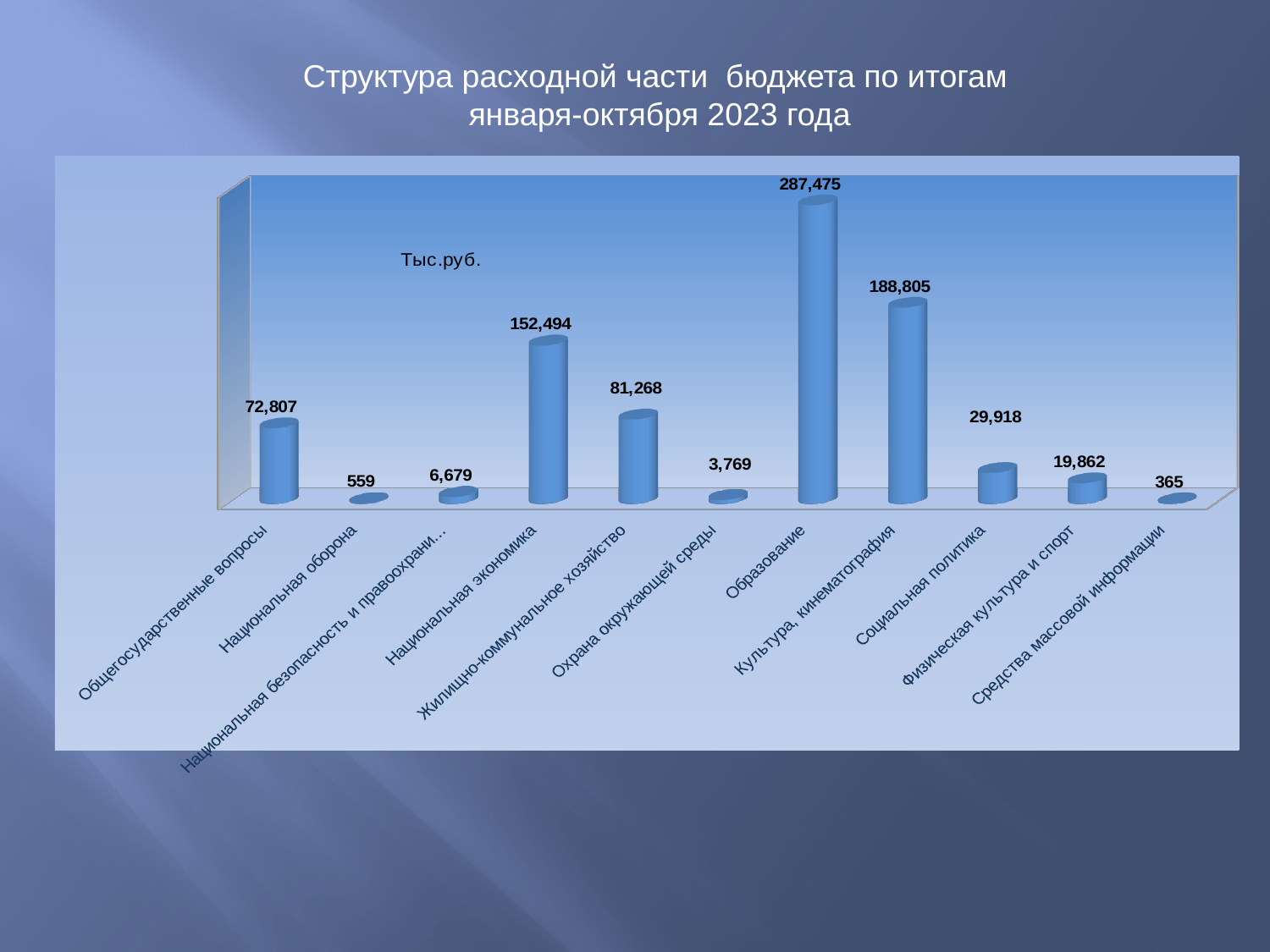
What kind of chart is shown on the slide? Bar chart What is the difference between the values for Образование and Культура, кинематография? 98,670 What is the value for Национальная экономика? 152,494 Which category has the highest value? Образование What is the value for Социальная политика? 29,918 Which category has the lowest value? Средства массовой информации What is the value for Охрана окружающей среды? 3,769 What unit is indicated on the chart? Тыс.руб. How many categories are shown in the chart? 11 What is the difference between the values for Национальная экономика and Жилищно-коммунальное хозяйство? 71,226 What is the value for Образование? 287,475 Which is larger, the value for Общегосударственные вопросы or the value for Жилищно-коммунальное хозяйство? Жилищно-коммунальное хозяйство